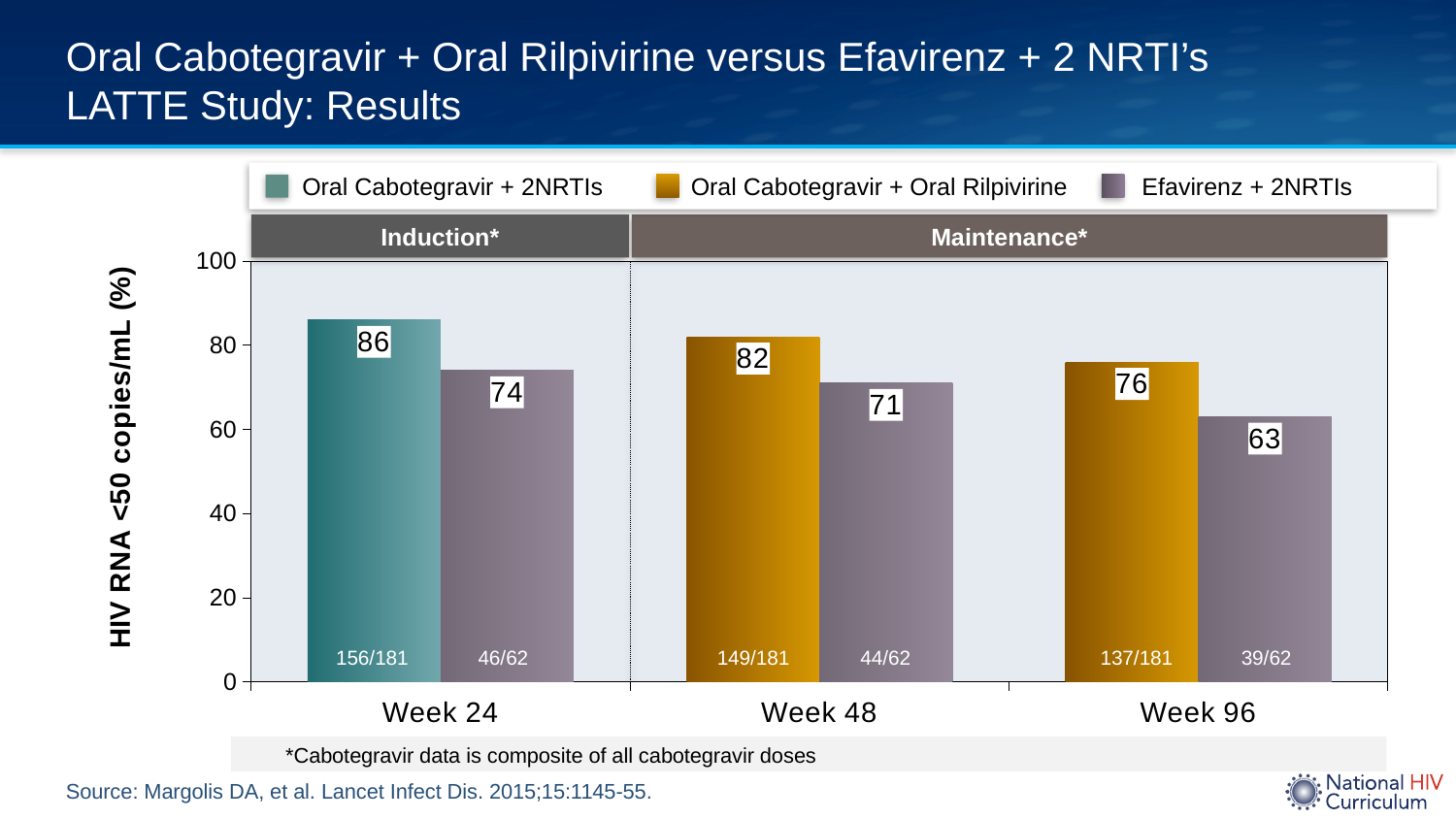
Do the Efavirenz + 2NRTIs values rise or fall from Week 24 to Week 96? Fall What kind of chart is shown on the slide? Bar chart What is the difference between the Oral Cabotegravir + Oral Rilpivirine and Efavirenz + 2NRTIs values at Week 96? 13 How many week time points are shown on the x axis? 3 What is the value for Efavirenz + 2NRTIs at Week 96? 63 Which bar on the chart has the lowest value? Efavirenz + 2NRTIs at Week 96 At Week 24, which is larger: Oral Cabotegravir + 2NRTIs or Efavirenz + 2NRTIs? Oral Cabotegravir + 2NRTIs How many series does the legend list? 3 What is the value for Oral Cabotegravir + Oral Rilpivirine at Week 48? 82 What fraction is printed on the Efavirenz + 2NRTIs bar at Week 48? 44/62 Which bar on the chart has the highest value? Oral Cabotegravir + 2NRTIs at Week 24 What is the value for Oral Cabotegravir + 2NRTIs at Week 24? 86